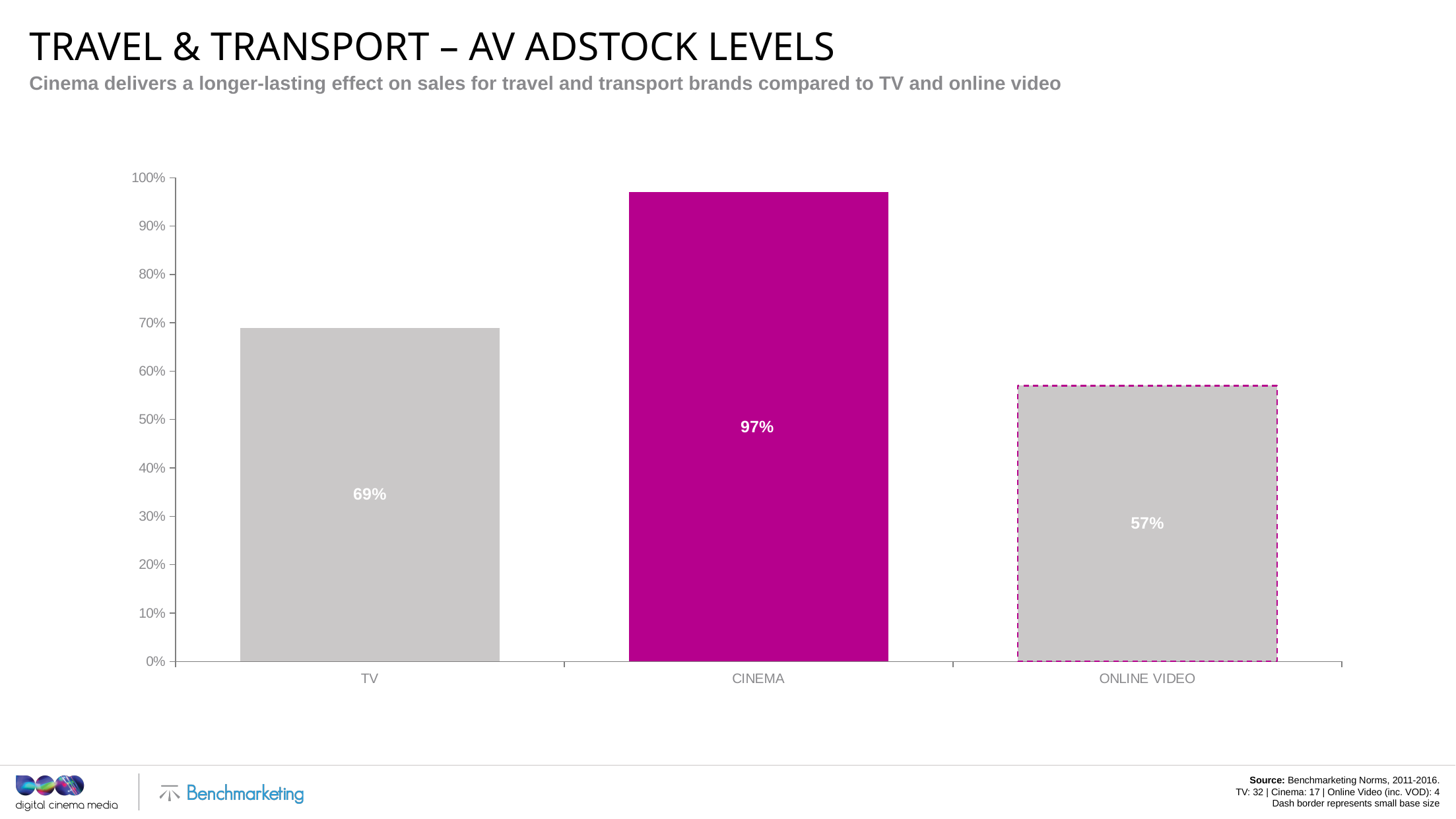
Which category has the highest adstock level? CINEMA What is the AV adstock level for TV? 69% Is the value for Online Video greater or less than 60%? less Which is larger, the adstock level for TV or for Online Video? TV How many categories are shown on the chart? 3 What is the difference between the Cinema and TV adstock levels? 28% Which bar is drawn with a dashed border? ONLINE VIDEO Which category has the lowest adstock level? ONLINE VIDEO What is the difference between the TV and Online Video adstock levels? 12% What is the AV adstock level for Online Video? 57% What kind of chart is shown on the slide? Bar chart What is the AV adstock level for Cinema? 97%